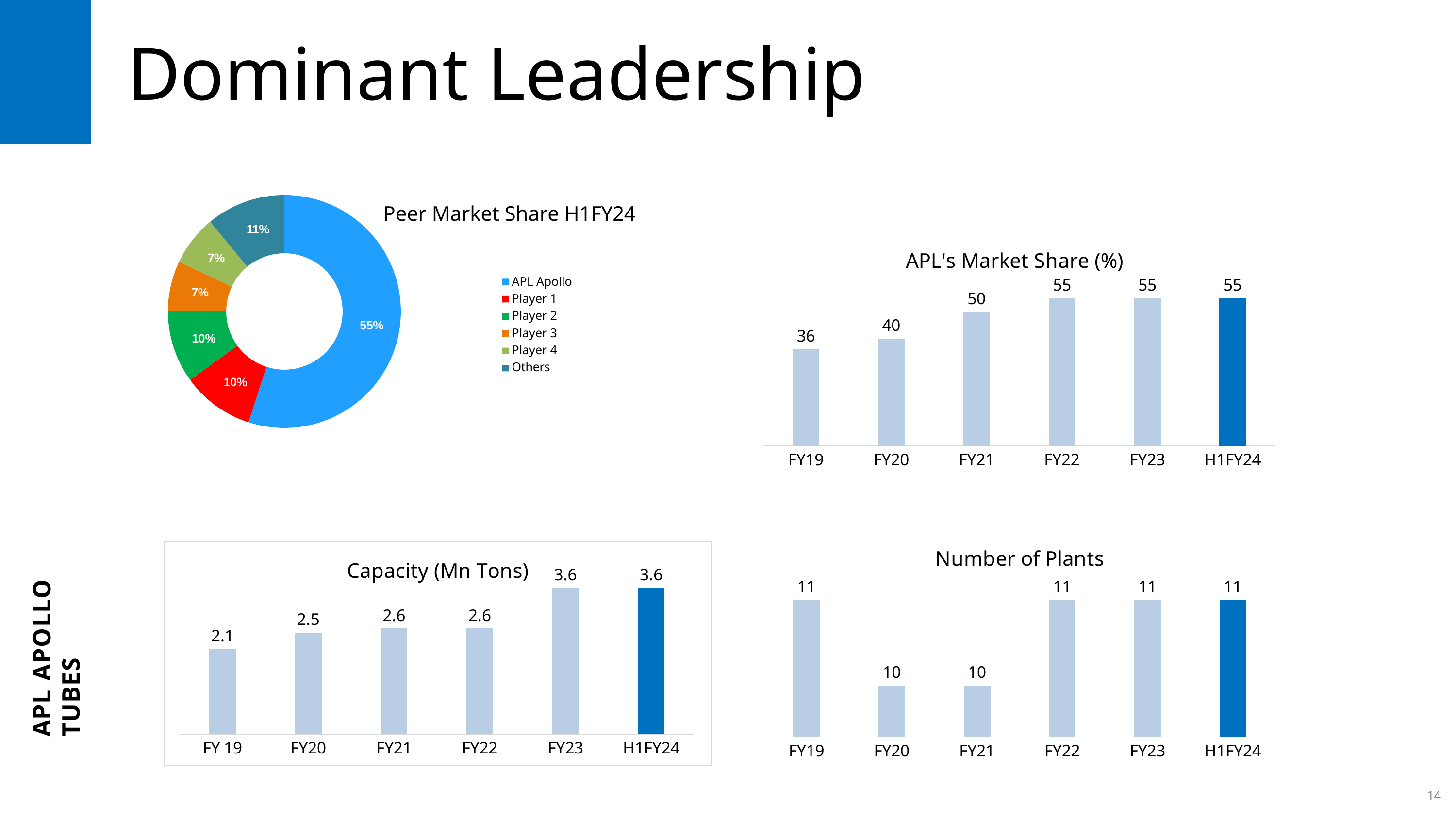
In the Number of Plants chart, which is larger, FY19 or FY21? FY19 In the Number of Plants chart, what is the value for FY20? 10 In the APL's Market Share (%) chart, what is the difference between FY21 and FY20? 10 In the Capacity (Mn Tons) chart, how many categories are shown on the x axis? 6 In the Peer Market Share H1FY24 chart, what share does Others hold? 11% In the Capacity (Mn Tons) chart, what is the value for FY23? 3.6 In the APL's Market Share (%) chart, which year has the lowest value? FY19 In the Peer Market Share H1FY24 chart, how many entries does the legend list? 6 In the Peer Market Share H1FY24 chart, what share does APL Apollo hold? 55% In the APL's Market Share (%) chart, do the values rise or fall from FY19 to FY22? Rise In the APL's Market Share (%) chart, what is the value for FY19? 36 What kind of chart is the Peer Market Share H1FY24 chart? Doughnut (pie) chart